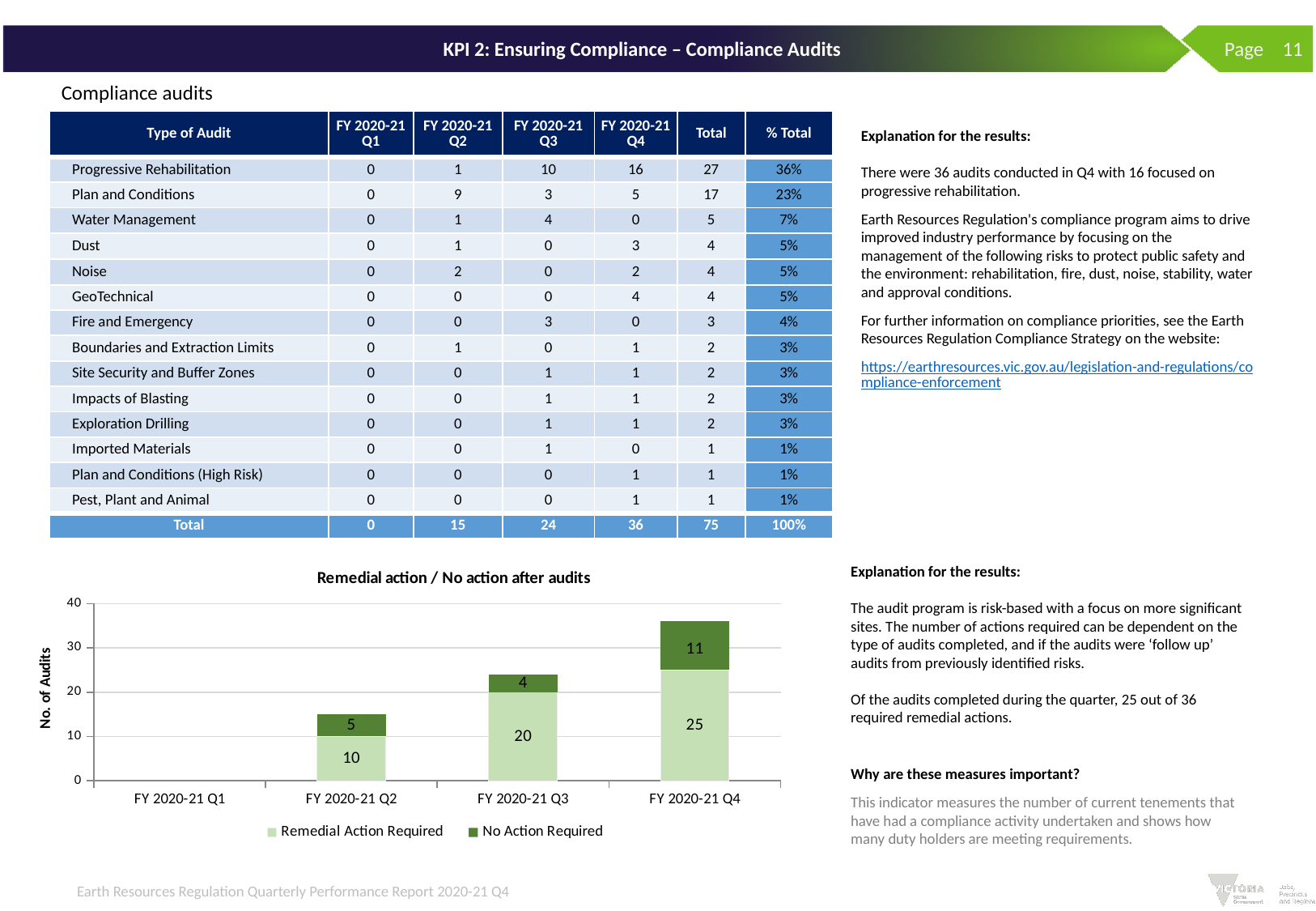
In the "Remedial action / No action after audits" chart, what is the value for Remedial Action Required in FY 2020-21 Q4? 25 In the "Remedial action / No action after audits" chart, which quarter has the highest value for Remedial Action Required? FY 2020-21 Q4 In the "Remedial action / No action after audits" chart, what is the value for No Action Required in FY 2020-21 Q3? 4 In the "Remedial action / No action after audits" chart, which quarter has the lowest value for No Action Required among the quarters with bars? FY 2020-21 Q3 In the "Remedial action / No action after audits" chart, which is larger: No Action Required in FY 2020-21 Q2 or in FY 2020-21 Q4? FY 2020-21 Q4 In the "Remedial action / No action after audits" chart, what is the difference between Remedial Action Required in FY 2020-21 Q4 and FY 2020-21 Q3? 5 How many quarters are shown on the x axis of the "Remedial action / No action after audits" chart? 4 How many series does the legend of the "Remedial action / No action after audits" chart list? 2 In the "Remedial action / No action after audits" chart, what is the total of the stacked bar for FY 2020-21 Q3? 24 In the "Remedial action / No action after audits" chart, what is the value for No Action Required in FY 2020-21 Q4? 11 In the "Remedial action / No action after audits" chart, what is the value for Remedial Action Required in FY 2020-21 Q2? 10 What type of chart is "Remedial action / No action after audits"? stacked bar chart